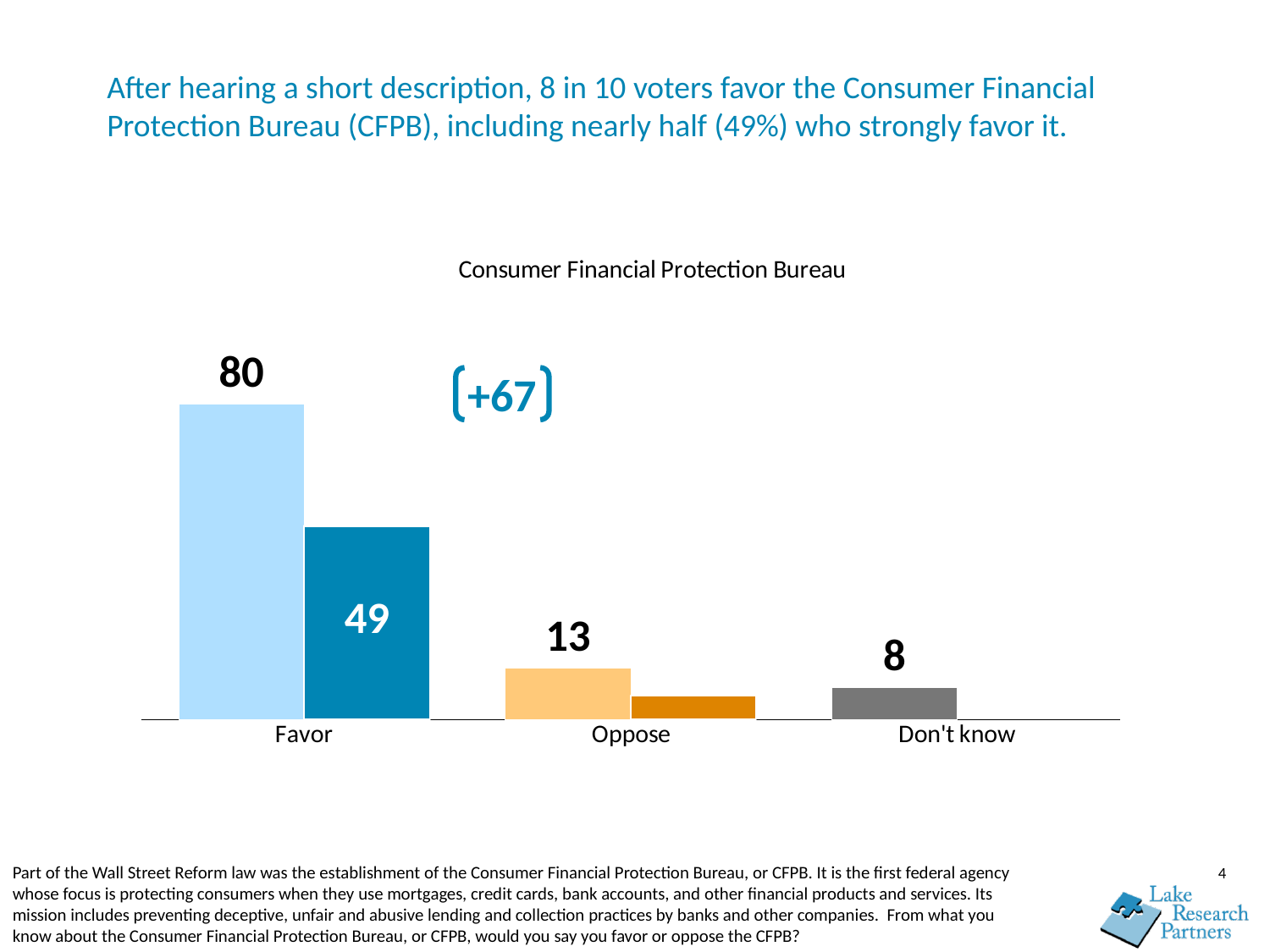
What kind of chart is shown on the slide? Bar chart Which is larger, the dark blue bar in Favor (49) or the Oppose value (13)? The dark blue bar in Favor (49) What is the value for Don't know? 8 Which category has the lowest labeled value? Don't know What net figure is printed in parentheses next to the Favor bars? (+67) Which category has the highest value? Favor Which is larger, the value for Oppose or the value for Don't know? Oppose How many categories are shown on the x axis? 3 What is the value for Oppose? 13 What is the difference between the Favor value and the Oppose value? 67 What value is printed on the dark blue bar within the Favor category? 49 What is the value for Favor in the Consumer Financial Protection Bureau chart? 80